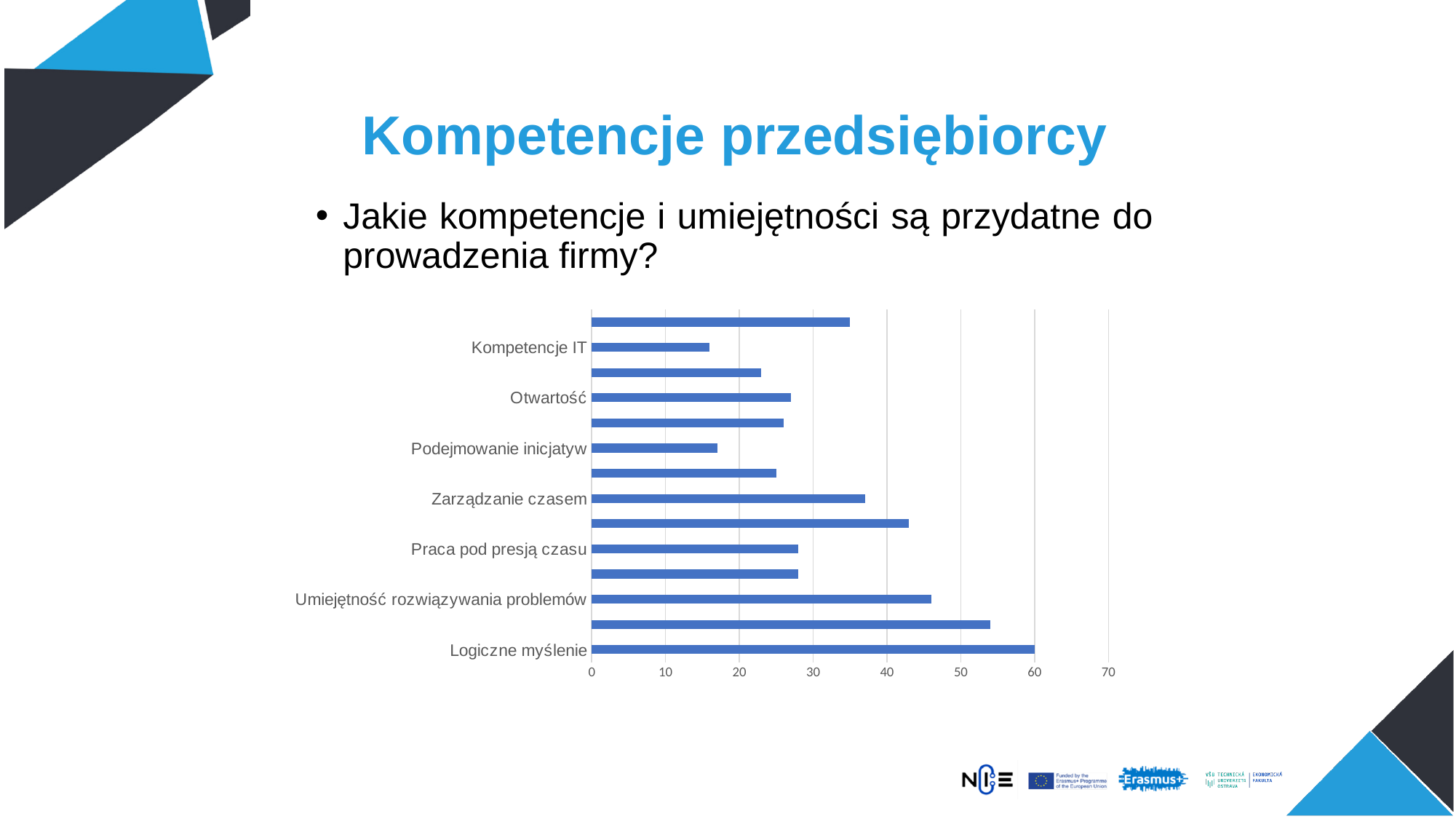
What is the highest value shown on the horizontal axis? 70 Which is larger, the value for Umiejętność rozwiązywania problemów or the value for Praca pod presją czasu? Umiejętność rozwiązywania problemów Is the value for Zarządzanie czasem greater or less than 30? greater Is the value for Podejmowanie inicjatyw greater or less than 20? less Is the value for Umiejętność rozwiązywania problemów greater or less than 40? greater Which labelled category has the longest bar? Logiczne myślenie How many bars are plotted in the chart? 14 Which is larger, the value for Zarządzanie czasem or the value for Otwartość? Zarządzanie czasem What kind of chart is shown on the slide? bar chart